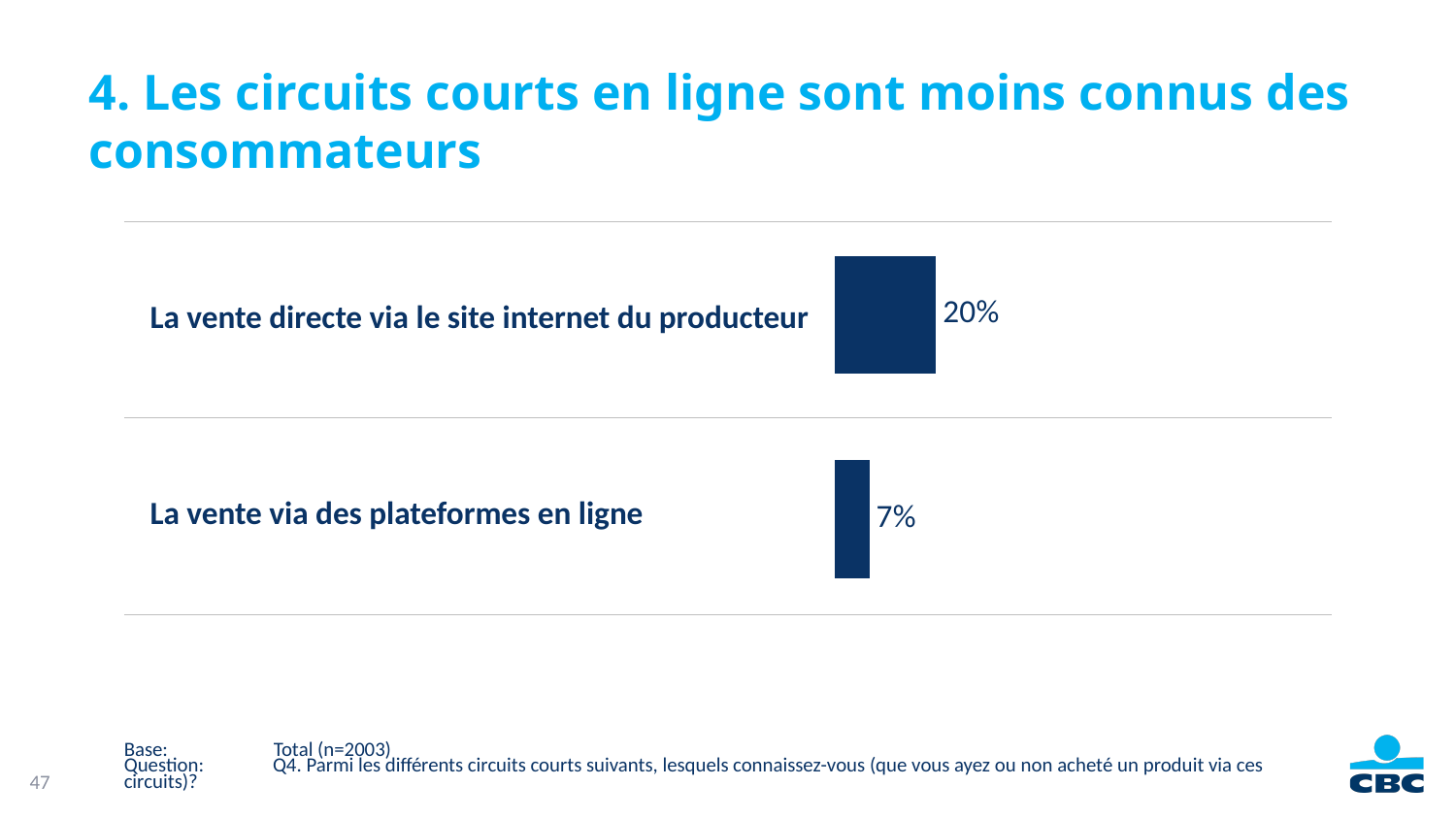
Which category has the highest value? La vente directe via le site internet du producteur Which is larger: the value for 'La vente directe via le site internet du producteur' or the value for 'La vente via des plateformes en ligne'? La vente directe via le site internet du producteur What is the sample size (n) given in the base note below the chart? 2003 What kind of chart is shown on the slide? Bar chart What is the total of the two values shown in the chart? 27% What colour are the bars in the chart? Dark blue What is the value for 'La vente directe via le site internet du producteur'? 20% How many categories are shown in the chart? 2 What is the value for 'La vente via des plateformes en ligne'? 7% What is the difference between the values for 'La vente directe via le site internet du producteur' and 'La vente via des plateformes en ligne'? 13% Which category has the lowest value? La vente via des plateformes en ligne